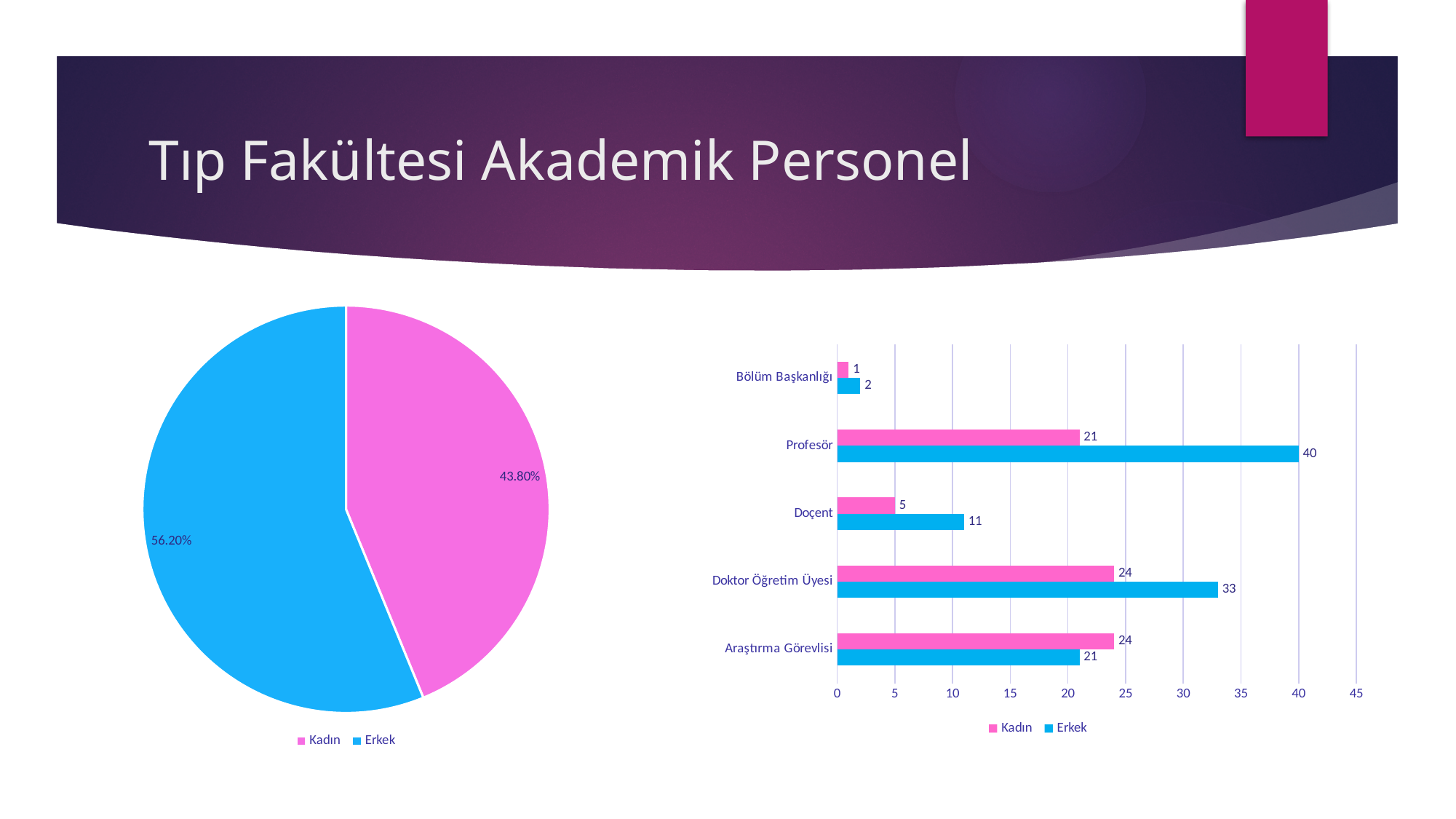
In the bar chart on the right, which category has the highest Erkek value? Profesör What kind of chart is the chart on the right? bar chart In the bar chart on the right, which category has the lowest Kadın value? Bölüm Başkanlığı In the bar chart on the right, what is the Erkek value for Profesör? 40 In the pie chart on the left, what share does Erkek have? 56.20% In the bar chart on the right, which is larger for Araştırma Görevlisi, Kadın or Erkek? Kadın In the bar chart on the right, what is the Kadın value for Doçent? 5 How many series does the legend of the bar chart on the right list? 2 In the pie chart on the left, what share does Kadın have? 43.80% In the pie chart on the left, which slice is larger, Kadın or Erkek? Erkek In the bar chart on the right, what is the difference between the Erkek and Kadın values for Profesör? 19 How many categories are shown in the bar chart on the right? 5